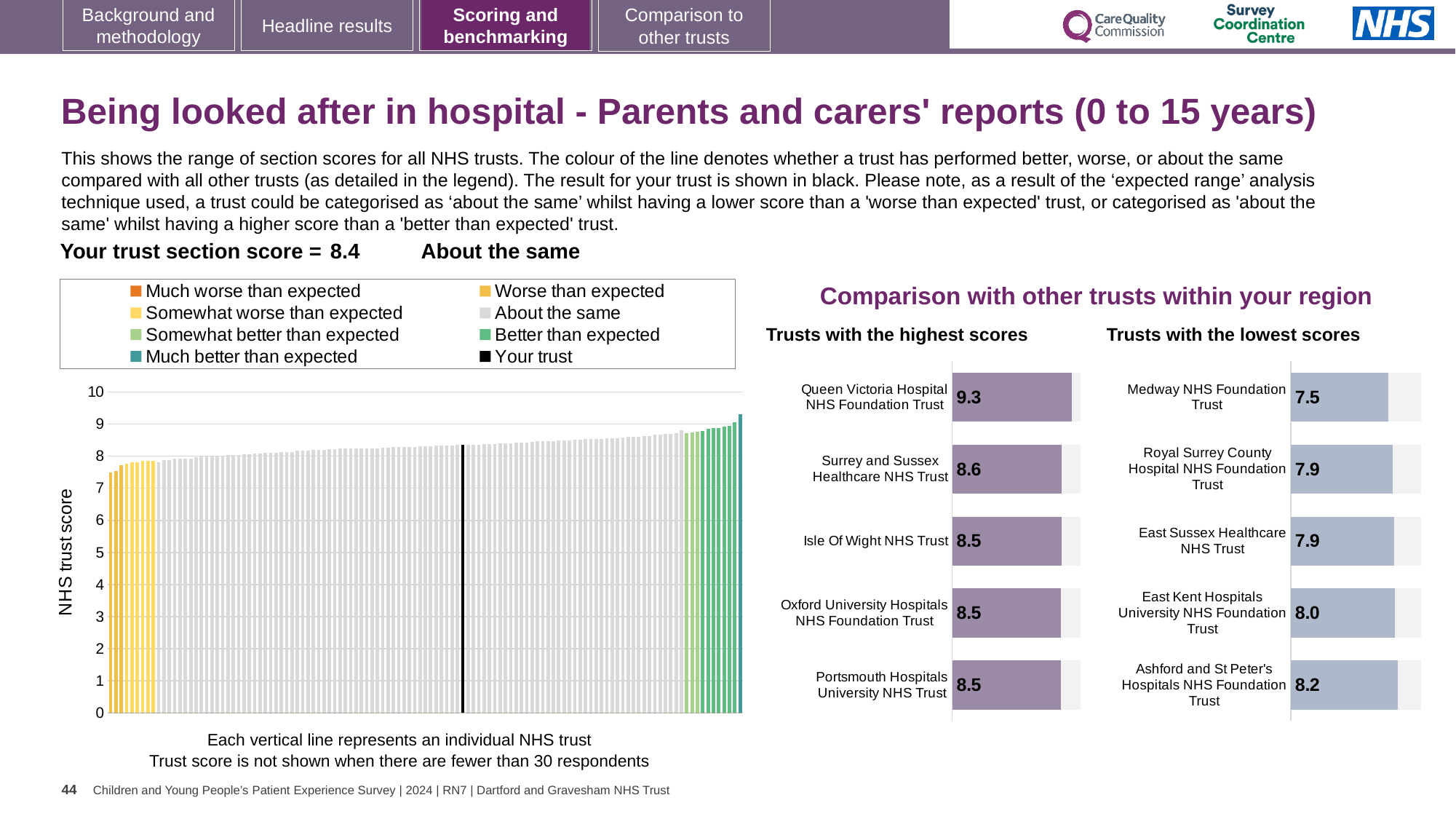
In the 'Trusts with the highest scores' chart, how many trusts are listed? 5 What kind of chart is the large chart on the left showing NHS trust scores? Bar chart In the 'Trusts with the highest scores' chart, which trust has the highest score? Queen Victoria Hospital NHS Foundation Trust In the 'Trusts with the highest scores' chart, what is the score for Queen Victoria Hospital NHS Foundation Trust? 9.3 In the 'Trusts with the highest scores' chart, what is the difference between the scores of Queen Victoria Hospital NHS Foundation Trust and Surrey and Sussex Healthcare NHS Trust? 0.7 In the 'Trusts with the highest scores' chart, what is the score for Surrey and Sussex Healthcare NHS Trust? 8.6 In the 'Trusts with the lowest scores' chart, which has the larger score: East Kent Hospitals University NHS Foundation Trust or Medway NHS Foundation Trust? East Kent Hospitals University NHS Foundation Trust In the 'Trusts with the lowest scores' chart, what is the score for Medway NHS Foundation Trust? 7.5 In the 'Trusts with the lowest scores' chart, what is the score for Ashford and St Peter's Hospitals NHS Foundation Trust? 8.2 In the 'Trusts with the lowest scores' chart, what is the difference between the scores of Ashford and St Peter's Hospitals NHS Foundation Trust and Medway NHS Foundation Trust? 0.7 How many entries does the legend of the large chart on the left list? 8 In the 'Trusts with the lowest scores' chart, which trust has the lowest score? Medway NHS Foundation Trust